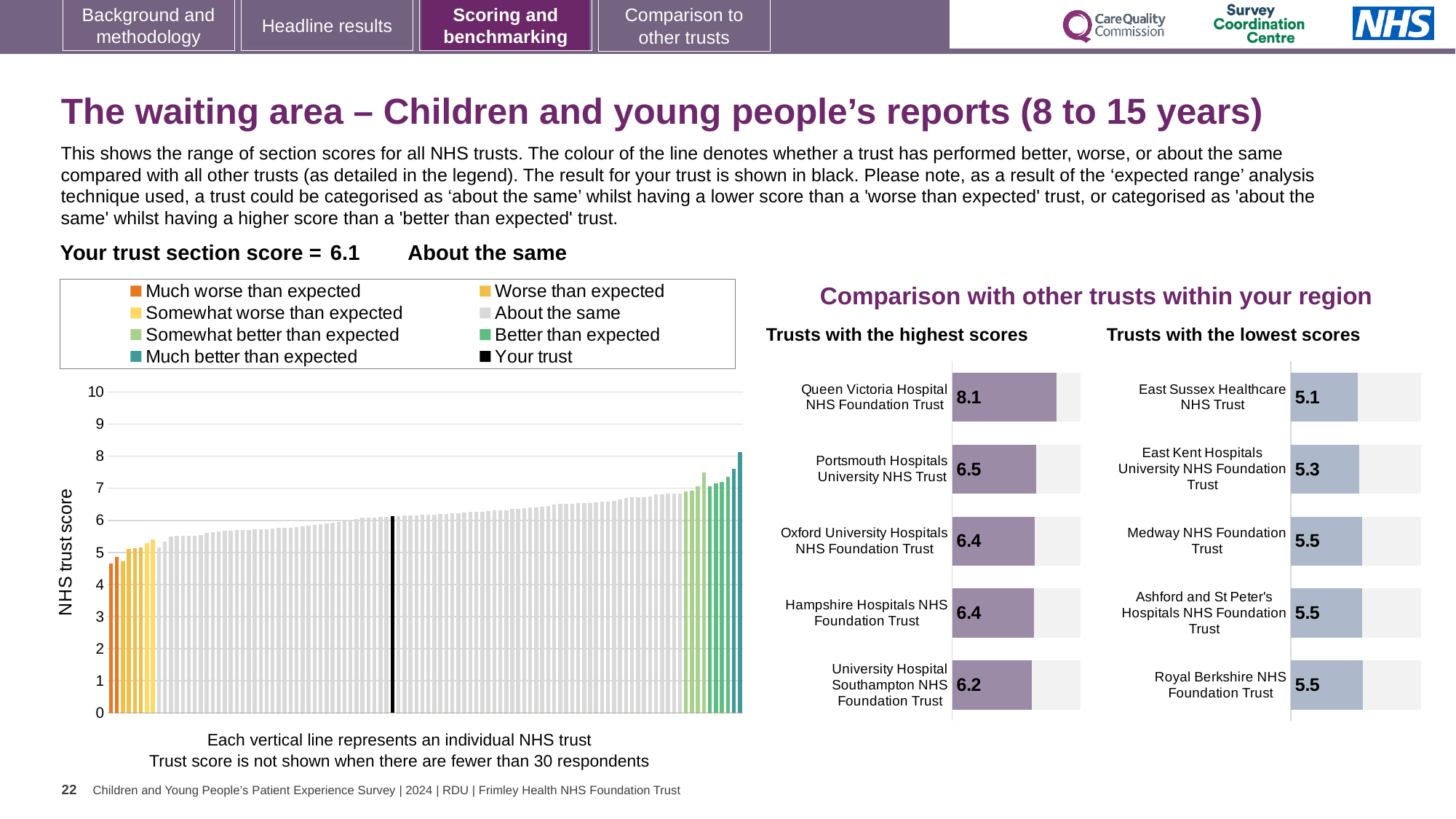
In the NHS trust score chart on the left, what is the section score for your trust? 6.1 What kind of chart is the NHS trust score chart on the left? Bar chart In the 'Trusts with the highest scores' chart, what is the difference between the scores of Queen Victoria Hospital NHS Foundation Trust and Portsmouth Hospitals University NHS Trust? 1.6 How many entries does the legend of the NHS trust score chart on the left list? 8 In the 'Trusts with the highest scores' chart, what is the score for Queen Victoria Hospital NHS Foundation Trust? 8.1 In the NHS trust score chart on the left, do the trust scores rise or fall from left to right? Rise How many trusts are shown in the 'Trusts with the lowest scores' chart? 5 In the 'Trusts with the lowest scores' chart, which trust has the lowest score? East Sussex Healthcare NHS Trust In the 'Trusts with the lowest scores' chart, what is the difference between the scores of East Kent Hospitals University NHS Foundation Trust and East Sussex Healthcare NHS Trust? 0.2 In the 'Trusts with the highest scores' chart, which trust has the highest score? Queen Victoria Hospital NHS Foundation Trust In the 'Trusts with the lowest scores' chart, what is the score for East Sussex Healthcare NHS Trust? 5.1 In the 'Trusts with the highest scores' chart, which has the larger score: Portsmouth Hospitals University NHS Trust or University Hospital Southampton NHS Foundation Trust? Portsmouth Hospitals University NHS Trust